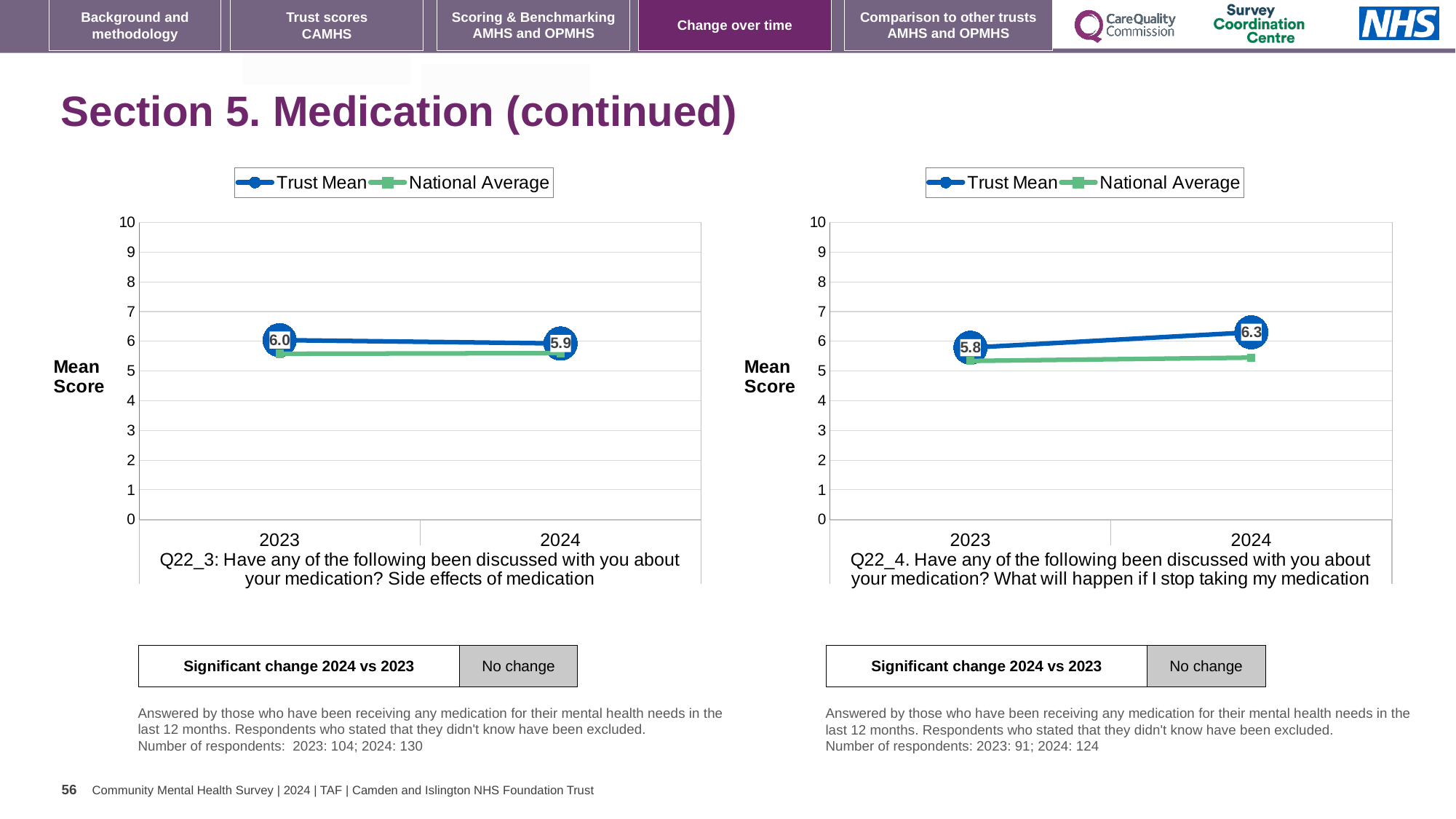
What kind of chart is used on this slide? line chart In the left chart (Q22_3), is the National Average for 2024 greater or less than 6? less In the right chart (Q22_4), by how much did the Trust Mean change from 2023 to 2024? 0.5 In the right chart (Q22_4), what is the Trust Mean score for 2023? 5.8 How many series does the legend of the left chart list? 2 How many years are plotted on the x axis of the right chart (Q22_4)? 2 In the right chart (Q22_4), what is the Trust Mean score for 2024? 6.3 In the right chart (Q22_4), does the Trust Mean rise or fall from 2023 to 2024? rise In the left chart (Q22_3), what is the difference between the Trust Mean in 2023 and 2024? 0.1 In the right chart (Q22_4), which year has the higher Trust Mean, 2023 or 2024? 2024 In the left chart (Q22_3), what is the Trust Mean score for 2024? 5.9 In the left chart (Q22_3), what is the Trust Mean score for 2023? 6.0